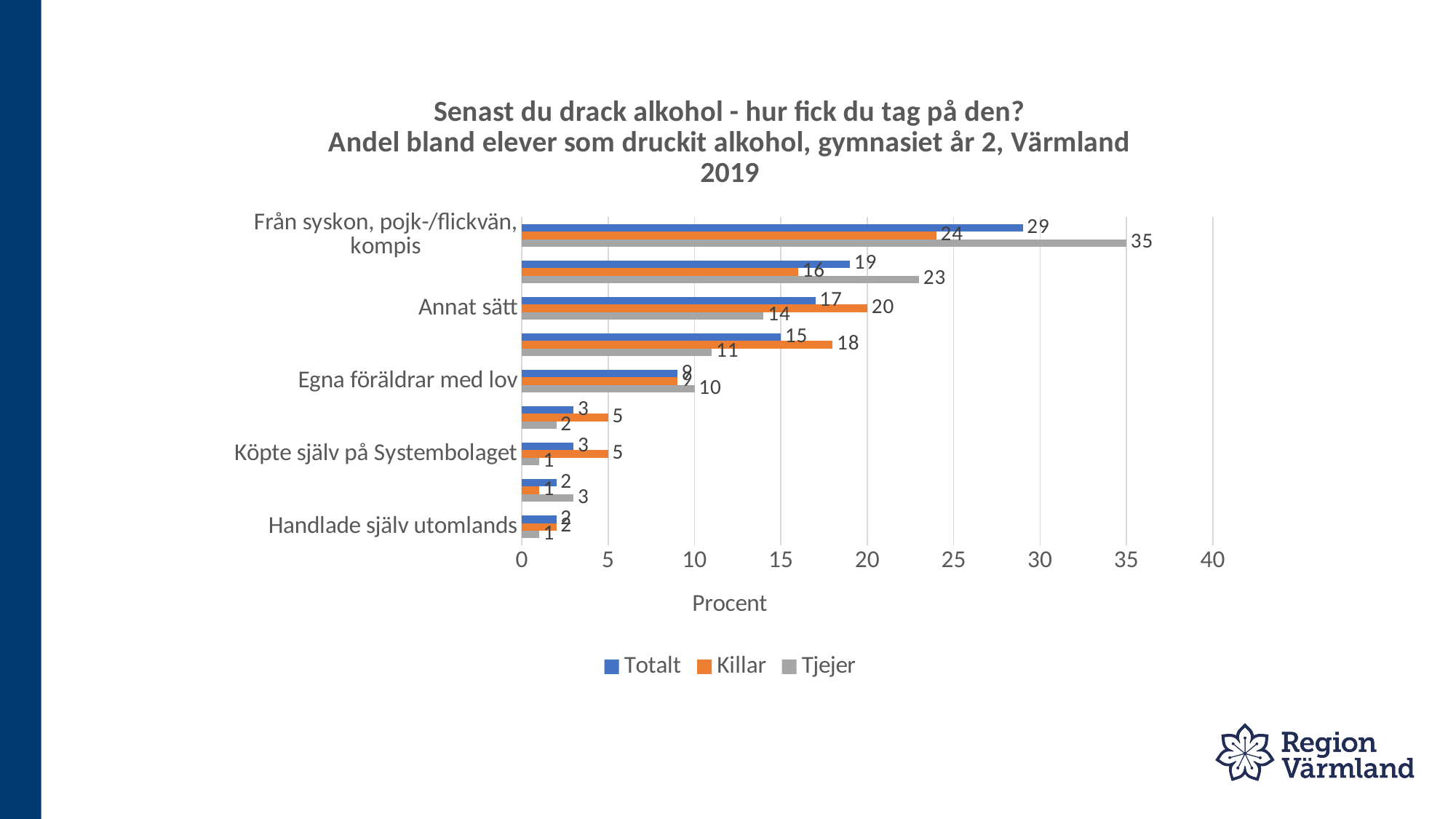
What is the Killar value for 'Från syskon, pojk-/flickvän, kompis'? 24 What is the Tjejer value for 'Egna föräldrar med lov'? 10 What is the Tjejer value for 'Från syskon, pojk-/flickvän, kompis'? 35 What is the Totalt value for 'Annat sätt'? 17 What is the Killar value for 'Annat sätt'? 20 What is the Tjejer value for 'Köpte själv på Systembolaget'? 1 For 'Annat sätt', which is larger: the Killar value or the Tjejer value? Killar What is the difference between the Tjejer and Killar values for 'Från syskon, pojk-/flickvän, kompis'? 11 Which labelled category has the highest Tjejer value? Från syskon, pojk-/flickvän, kompis How many series does the legend list? 3 What is the title of the horizontal axis? Procent What kind of chart is shown on the slide? bar chart